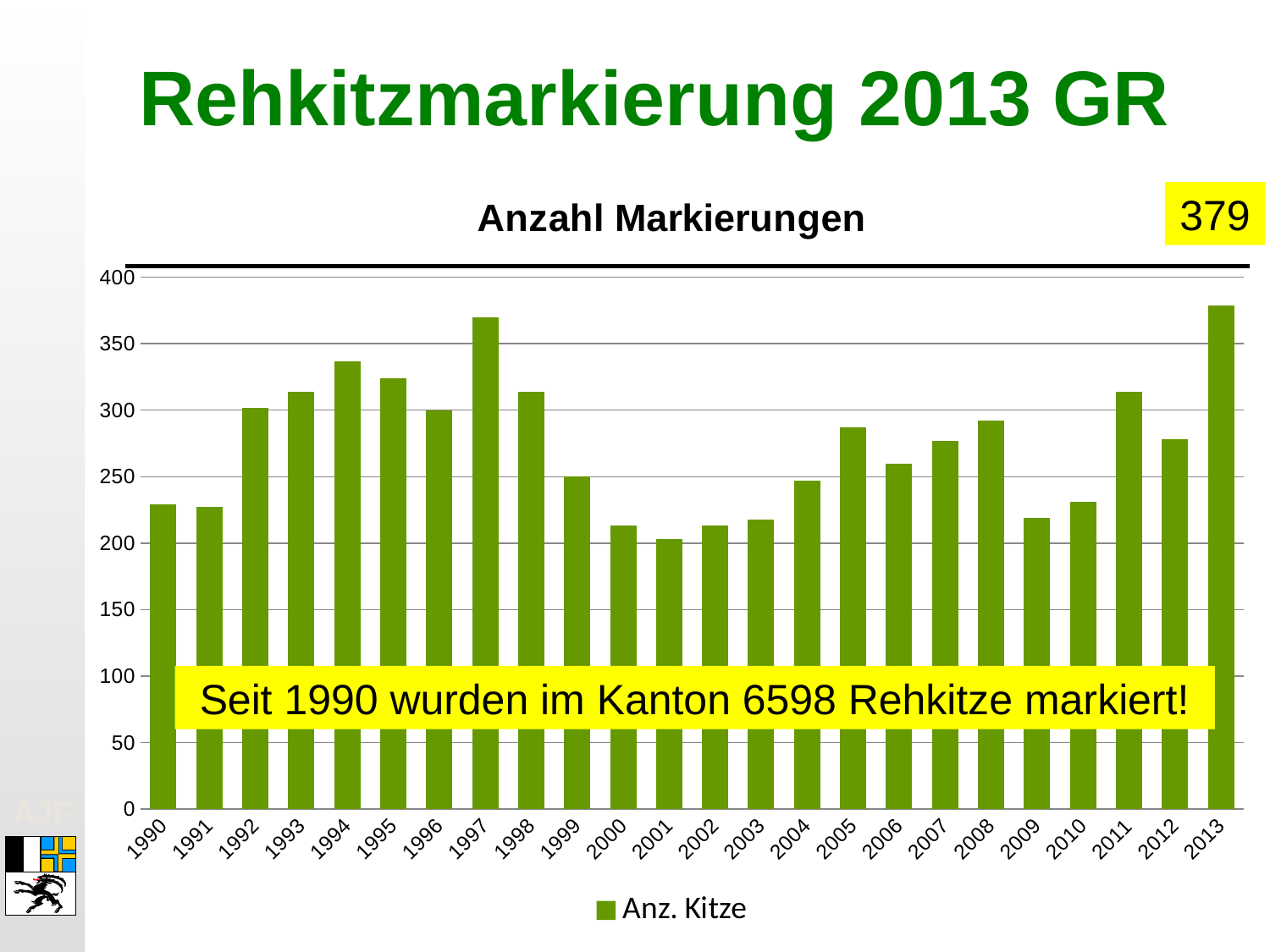
Which year has the lowest number of markings? 2001 What is the title of the chart? Anzahl Markierungen Which year has the larger value, 1997 or 1994? 1997 Is the value for 2009 greater or less than 250? less How many years are shown on the x axis? 24 What kind of chart is shown on the slide? bar chart What is the name of the series shown in the legend? Anz. Kitze Do the values rise or fall from 1997 to 2001? fall Is the value for 1997 greater or less than 350? greater Which year has the highest number of markings? 2013 How many series does the legend list? 1 What is the number of markings for 2013? 379